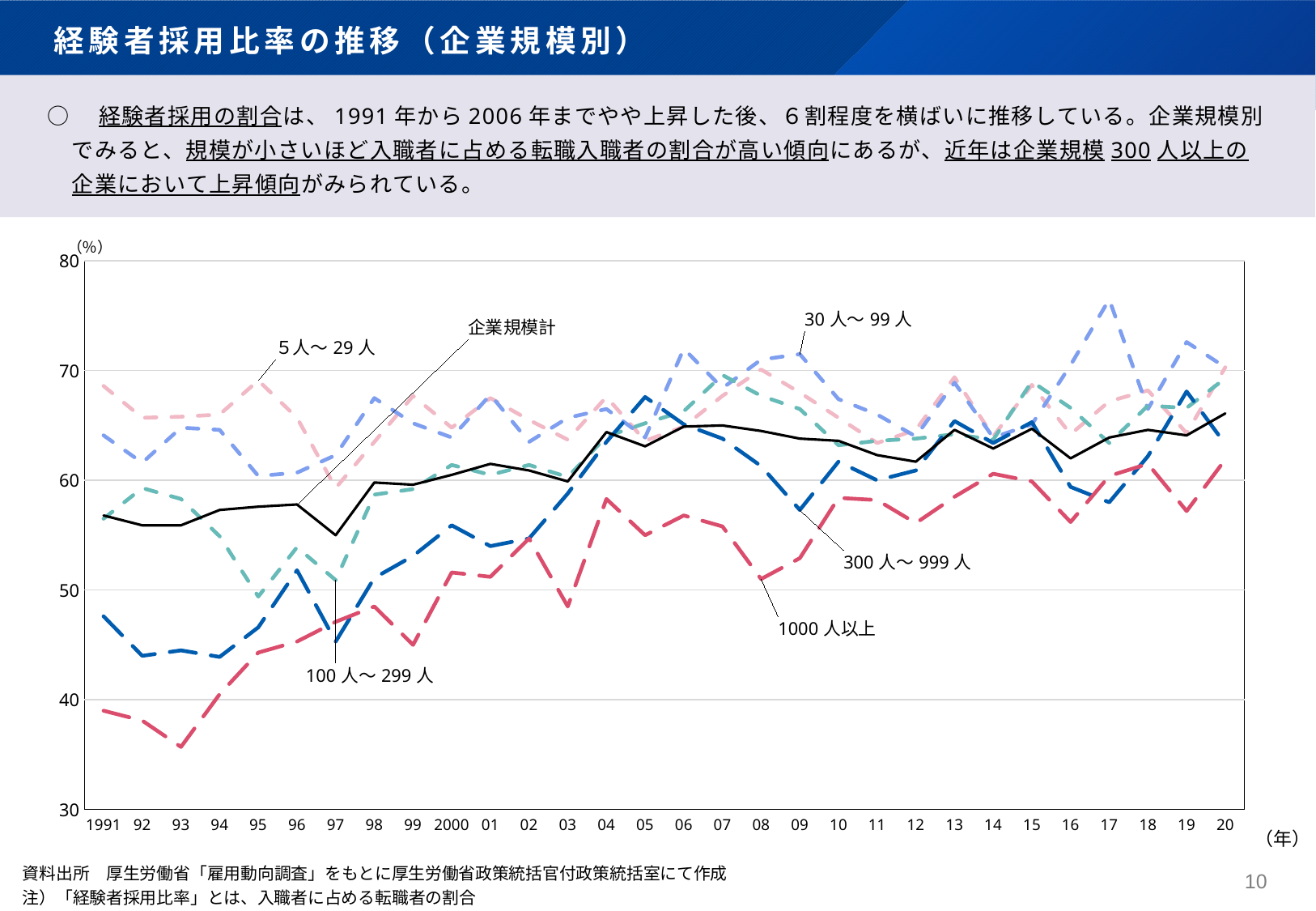
What unit is shown on the y axis of the chart? % In 1993, which is larger: the value for 5人〜29人 or the value for 1000人以上? 5人〜29人 Which series has the lowest value in 1993? 1000人以上 How many years are plotted along the x axis of the chart? 30 Is the value for 1000人以上 in 1993 greater or less than 40? less What kind of chart is shown on the slide? line chart Is the value for 30人〜99人 in 2017 greater or less than 70? greater Which series has the highest value in 2017? 30人〜99人 How many series are labelled on the chart? 6 Is the value for 企業規模計 in 1997 greater or less than 60? less What is the title of the chart on the slide? 経験者採用比率の推移（企業規模別）